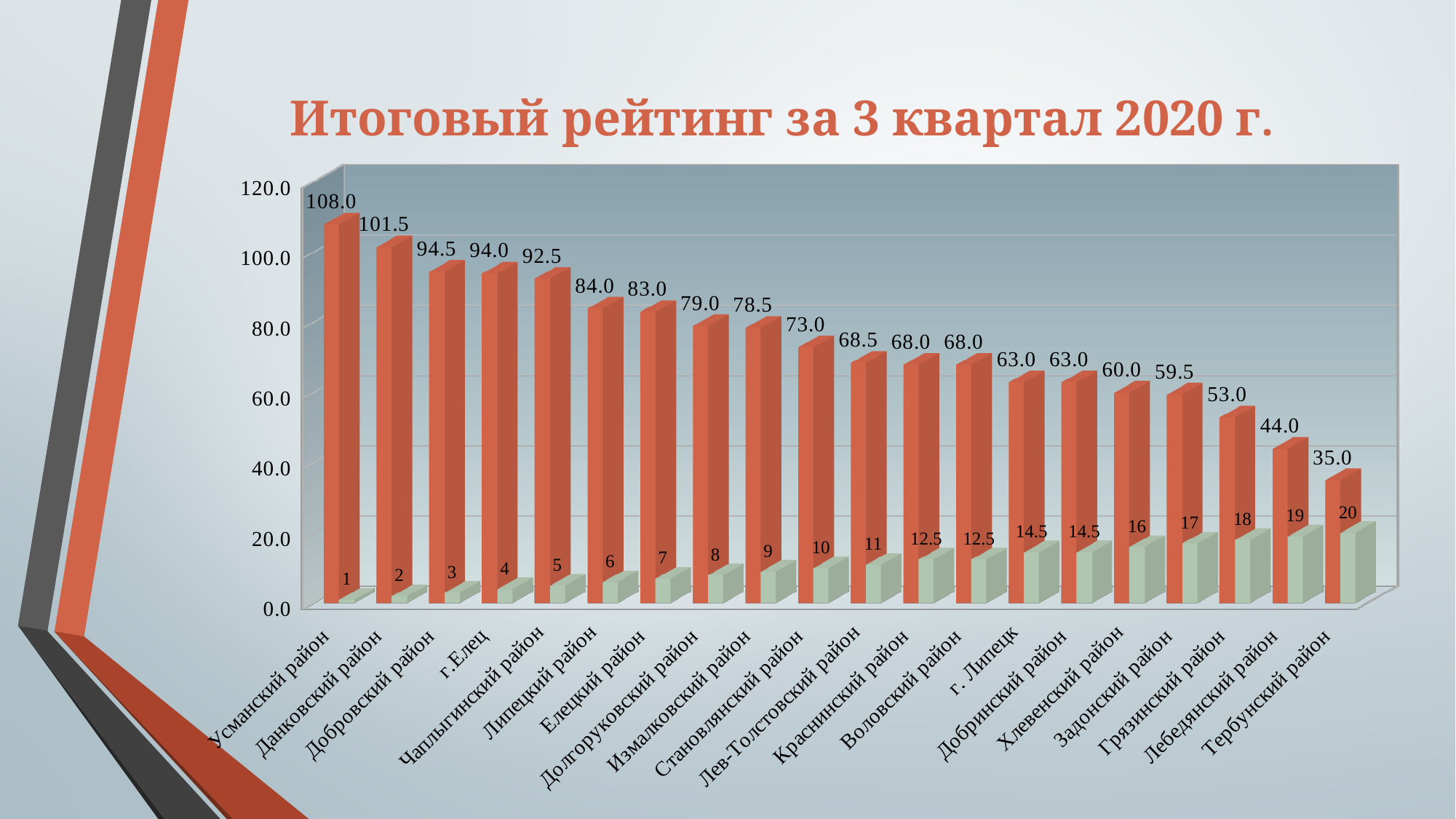
What is the rating value (orange bar) for Усманский район? 108.0 Which district has the lowest rating value in the chart? Тербунский район Which district has the highest rating value in the chart? Усманский район Which has a higher rating value, Липецкий район or Грязинский район? Липецкий район Do the rating values (orange bars) rise or fall from left to right along the x axis? fall What is the rating value (orange bar) for Тербунский район? 35.0 What is the rank value (green bar) shown for Краснинский район? 12.5 What type of chart is shown on the slide? bar chart What is the title of the chart? Итоговый рейтинг за 3 квартал 2020 г. How many categories (districts) are shown on the x axis of the chart? 20 What is the difference between the rating values of Усманский район and Данковский район? 6.5 What is the rating value (orange bar) for г. Липецк? 63.0